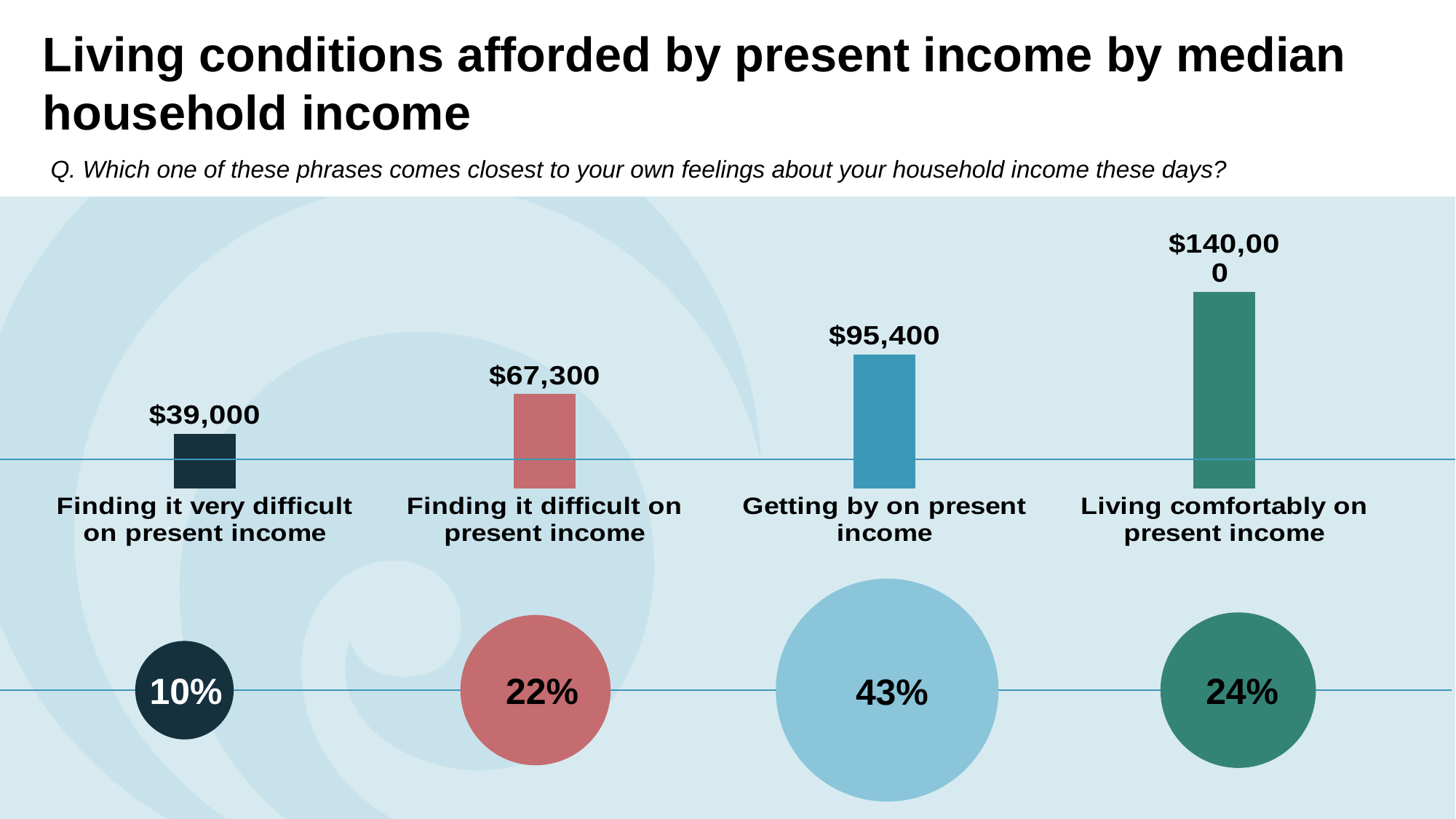
How many categories are shown in the bar chart? 4 What is the median household income for 'Finding it very difficult on present income'? $39,000 Do the median household income values rise or fall from left to right across the categories? Rise Which category has the lowest median household income? Finding it very difficult on present income What is the median household income for 'Getting by on present income'? $95,400 What is the median household income for 'Finding it difficult on present income'? $67,300 Which category has the highest median household income? Living comfortably on present income What is the difference in median household income between 'Living comfortably on present income' and 'Finding it very difficult on present income'? $101,000 In the bubbles below the bar chart, what percentage is shown for 'Getting by on present income'? 43% What is the median household income for 'Living comfortably on present income'? $140,000 What kind of chart shows the median household income values? Bar chart Which has a higher median household income: 'Getting by on present income' or 'Finding it difficult on present income'? Getting by on present income